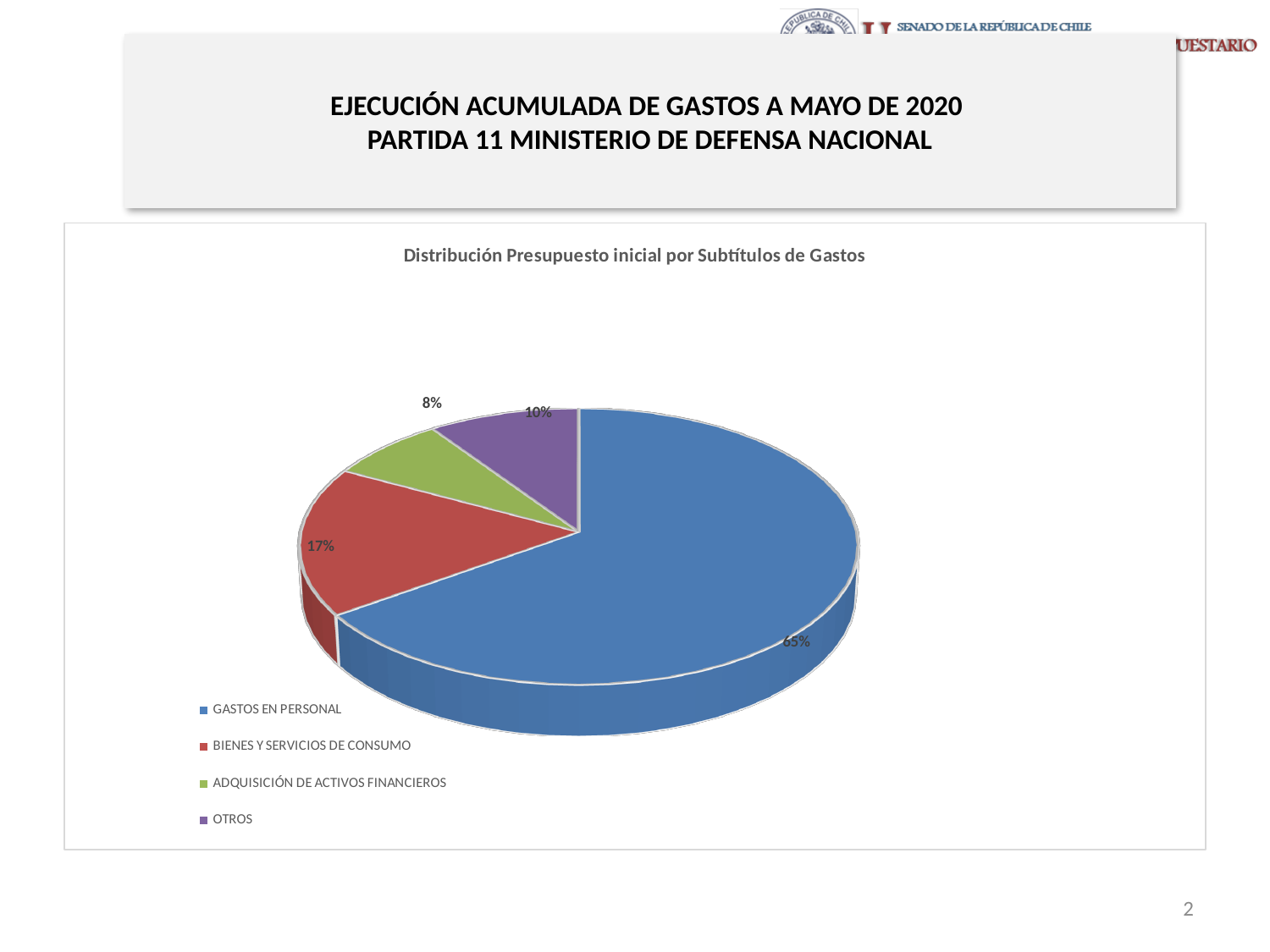
Which category has the largest share of the pie? GASTOS EN PERSONAL What kind of chart is shown on the slide? Pie chart What share of the pie does ADQUISICIÓN DE ACTIVOS FINANCIEROS represent? 8% What is the title of the chart? Distribución Presupuesto inicial por Subtítulos de Gastos What share of the pie does OTROS represent? 10% What is the difference in percentage points between GASTOS EN PERSONAL and BIENES Y SERVICIOS DE CONSUMO? 48 percentage points What share of the pie does BIENES Y SERVICIOS DE CONSUMO represent? 17% Which is larger, the share for OTROS or the share for ADQUISICIÓN DE ACTIVOS FINANCIEROS? OTROS How many categories does the pie chart show? 4 Which category has the smallest share of the pie? ADQUISICIÓN DE ACTIVOS FINANCIEROS Which colour represents BIENES Y SERVICIOS DE CONSUMO in the chart? Red